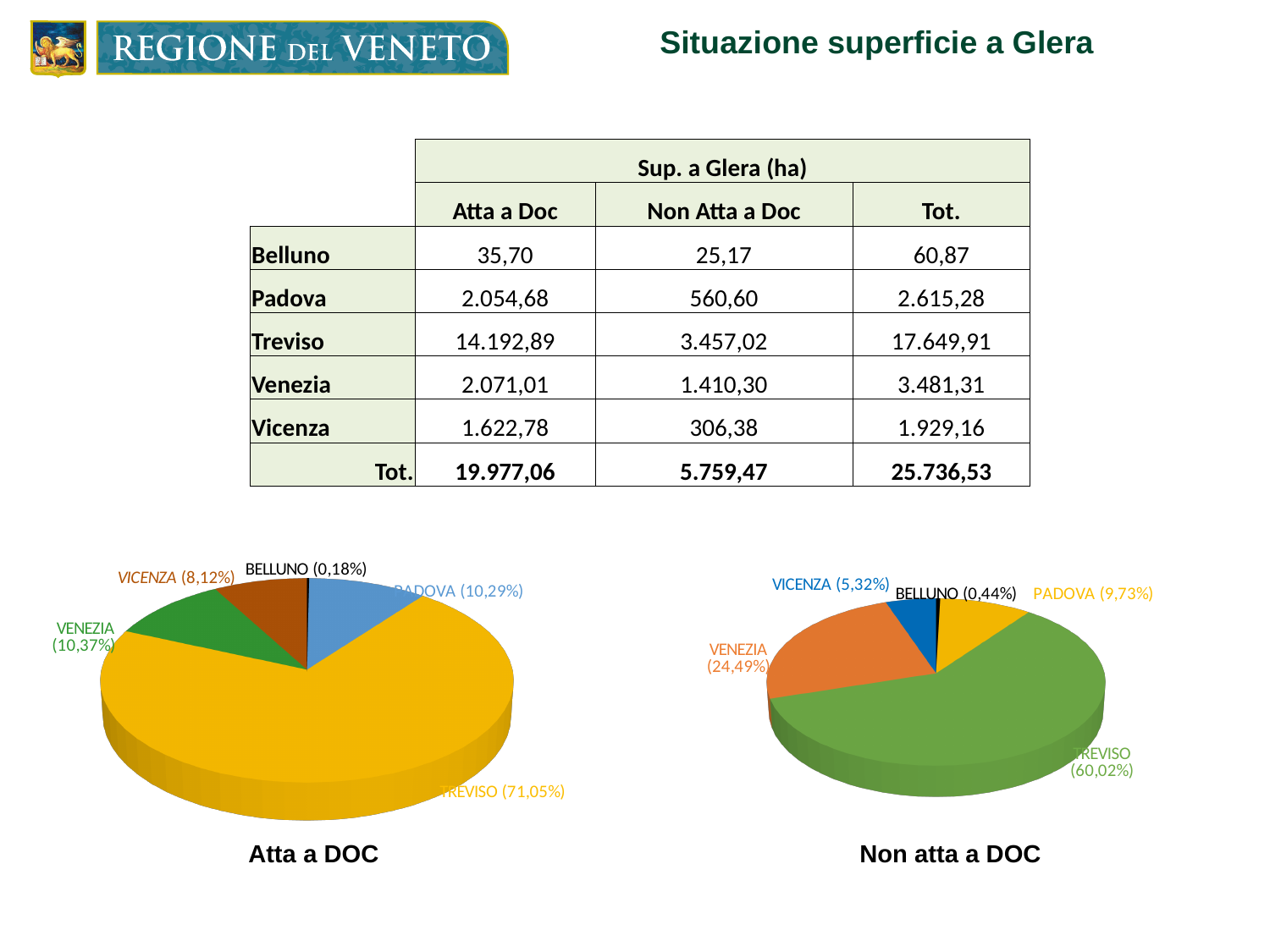
In the 'Atta a DOC' pie chart, what is the difference in percentage points between the TREVISO share and the VICENZA share? 62,93 In the 'Non atta a DOC' pie chart, what share does VENEZIA have? 24,49% In the 'Non atta a DOC' pie chart, what share does PADOVA have? 9,73% In the 'Atta a DOC' pie chart, what share does BELLUNO have? 0,18% What kind of chart is the 'Non atta a DOC' chart? Pie chart In the 'Non atta a DOC' pie chart, which province has the largest slice? TREVISO How many slices does the 'Atta a DOC' pie chart have? 5 In the 'Atta a DOC' pie chart, which province has the largest slice? TREVISO In the 'Non atta a DOC' pie chart, which is larger, the VENEZIA slice or the VICENZA slice? VENEZIA In the 'Non atta a DOC' pie chart, what is the difference in percentage points between the VENEZIA share and the PADOVA share? 14,76 In the 'Non atta a DOC' pie chart, which province has the smallest slice? BELLUNO